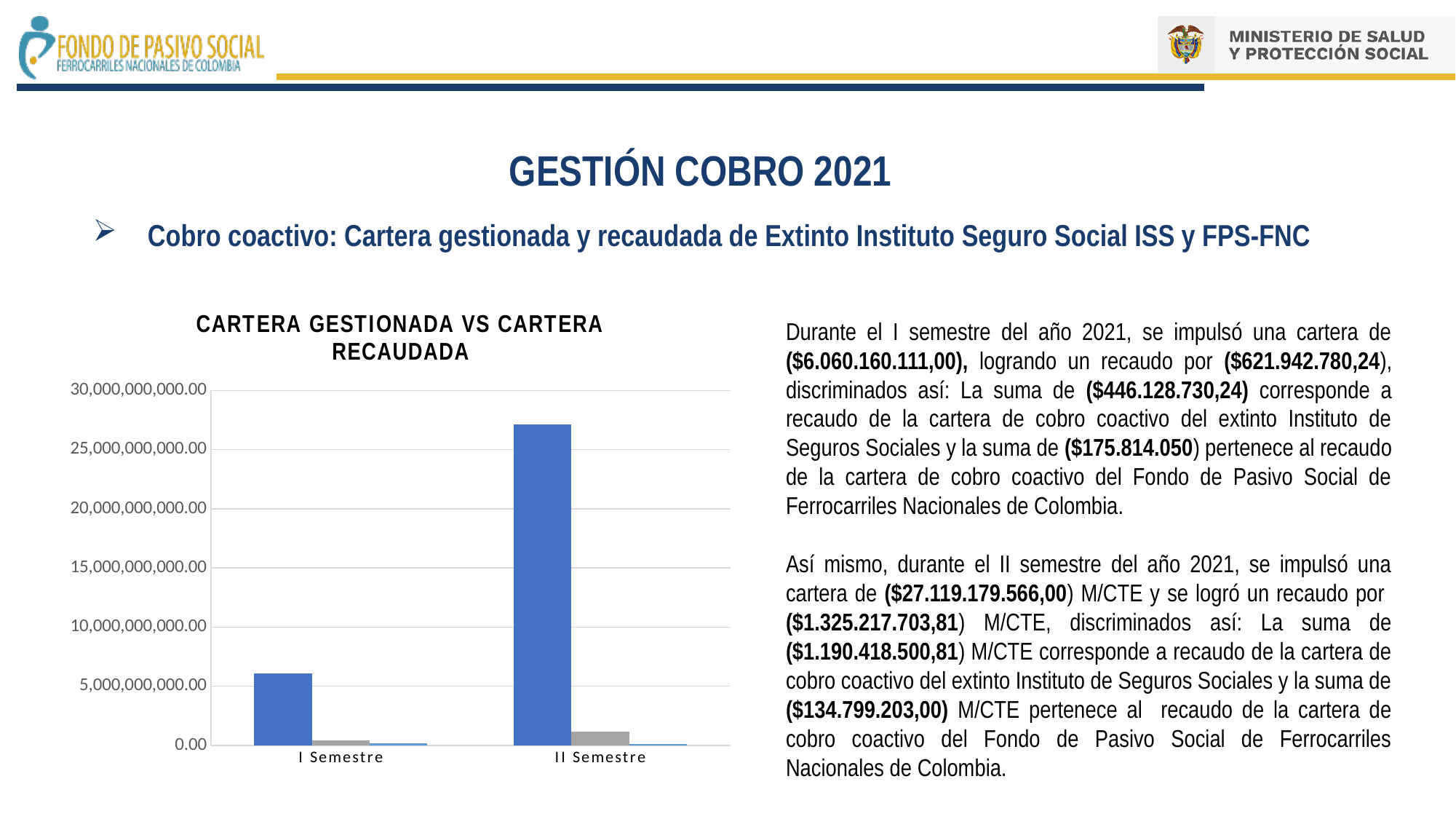
What is the title of the chart? CARTERA GESTIONADA VS CARTERA RECAUDADA Do the blue bars rise or fall from I Semestre to II Semestre? Rise What type of chart is shown on the slide? Bar chart Is the blue bar for I Semestre greater or less than 10,000,000,000.00? less Which category has the shortest blue bar in the chart? I Semestre Is the blue bar for I Semestre greater or less than 5,000,000,000.00? greater How many categories are shown on the x axis of the chart? 2 Which is larger, the blue bar for I Semestre or the blue bar for II Semestre? II Semestre Which category has the tallest blue bar in the chart? II Semestre What are the two categories on the x axis of the chart? I Semestre and II Semestre Is the gray bar for II Semestre greater or less than 5,000,000,000.00? less